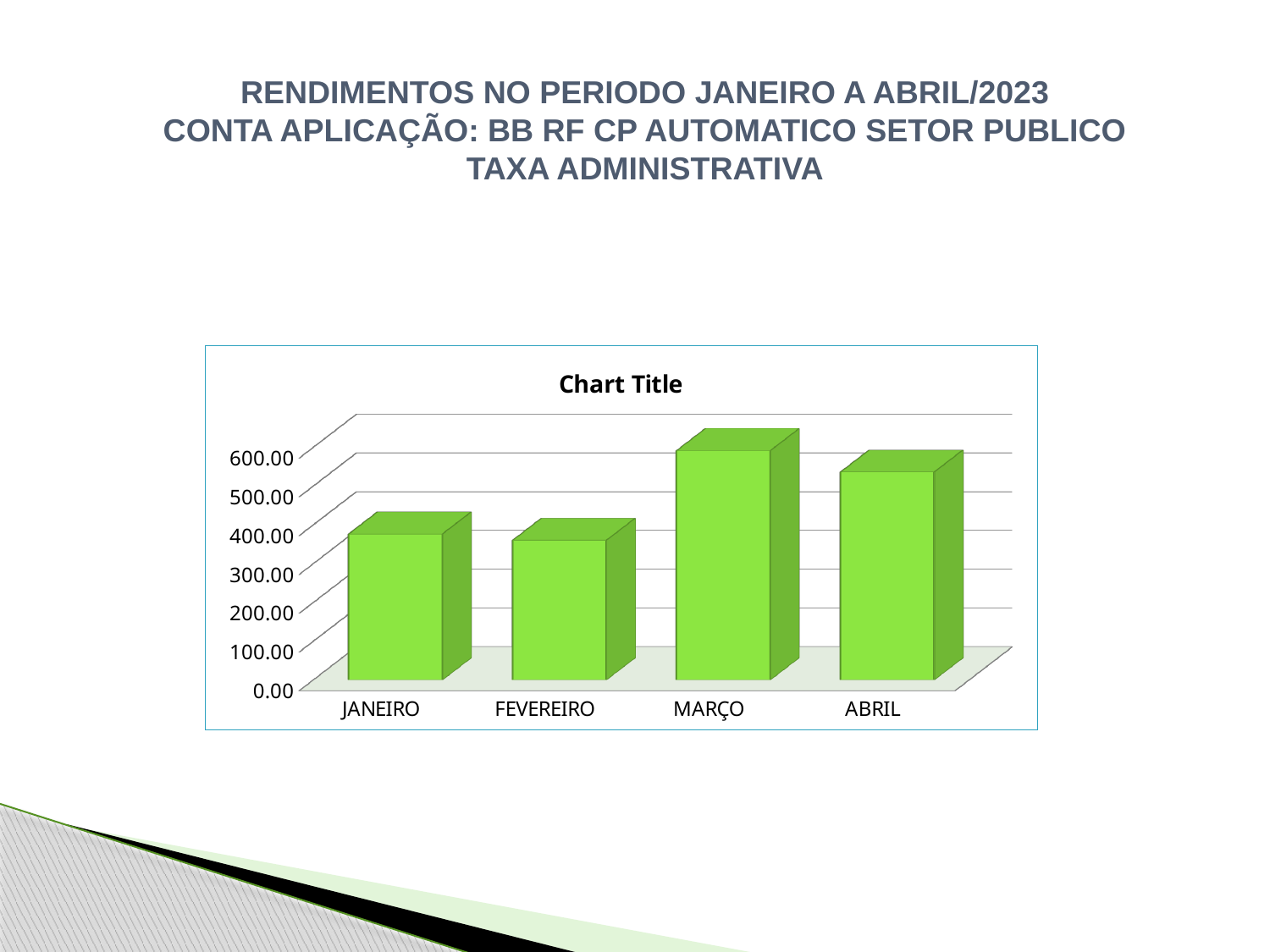
Is the value for FEVEREIRO greater or less than 500.00? less What is the title printed above the chart? Chart Title Is the value for JANEIRO greater or less than 600.00? less Is the value for ABRIL greater or less than 400.00? greater What kind of chart is shown on the slide? bar chart How many categories are shown on the x axis of the chart? 4 Which month has the highest value in the chart? MARÇO Which is larger, the value for JANEIRO or the value for MARÇO? MARÇO Does the value rise or fall from FEVEREIRO to MARÇO? rise Which is larger, the value for MARÇO or the value for ABRIL? MARÇO